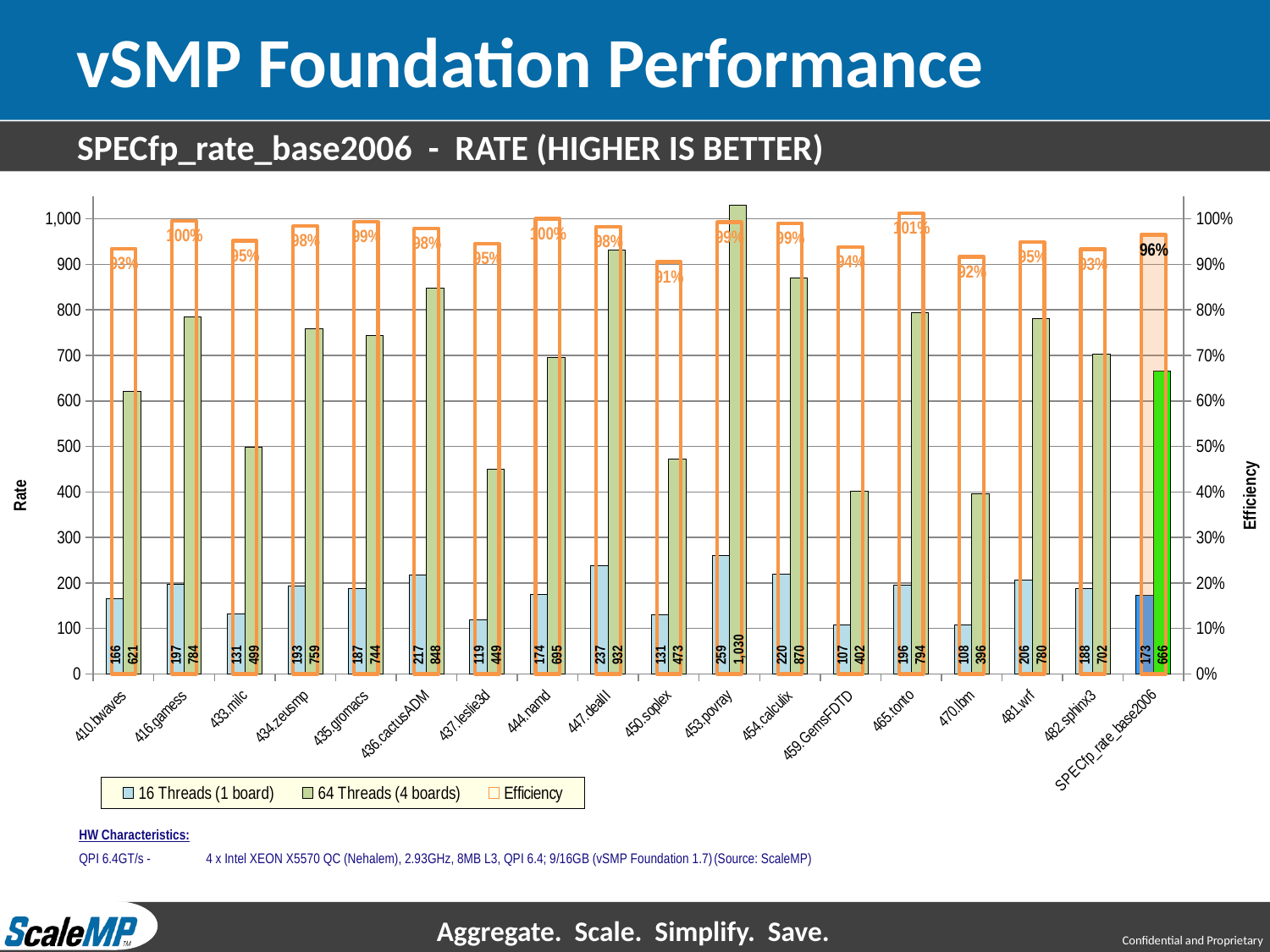
How many categories are shown on the x axis? 18 What is the 16 Threads (1 board) value for 436.cactusADM? 217 What is the difference between the 64 Threads (4 boards) and 16 Threads (1 board) values for 453.povray? 771 Is the 64 Threads (4 boards) value for 433.milc greater or less than 600? less What is the 64 Threads (4 boards) value for SPECfp_rate_base2006? 666 Which category has the lowest 64 Threads (4 boards) value? 470.lbm Which category has the highest 64 Threads (4 boards) value? 453.povray How many series does the legend list? 3 What kind of chart is shown on the slide? bar chart What is the Efficiency value shown for 465.tonto? 101% What is the 64 Threads (4 boards) value for 453.povray? 1,030 Which is larger, the 64 Threads (4 boards) value for 447.dealII or for 454.calculix? 447.dealII